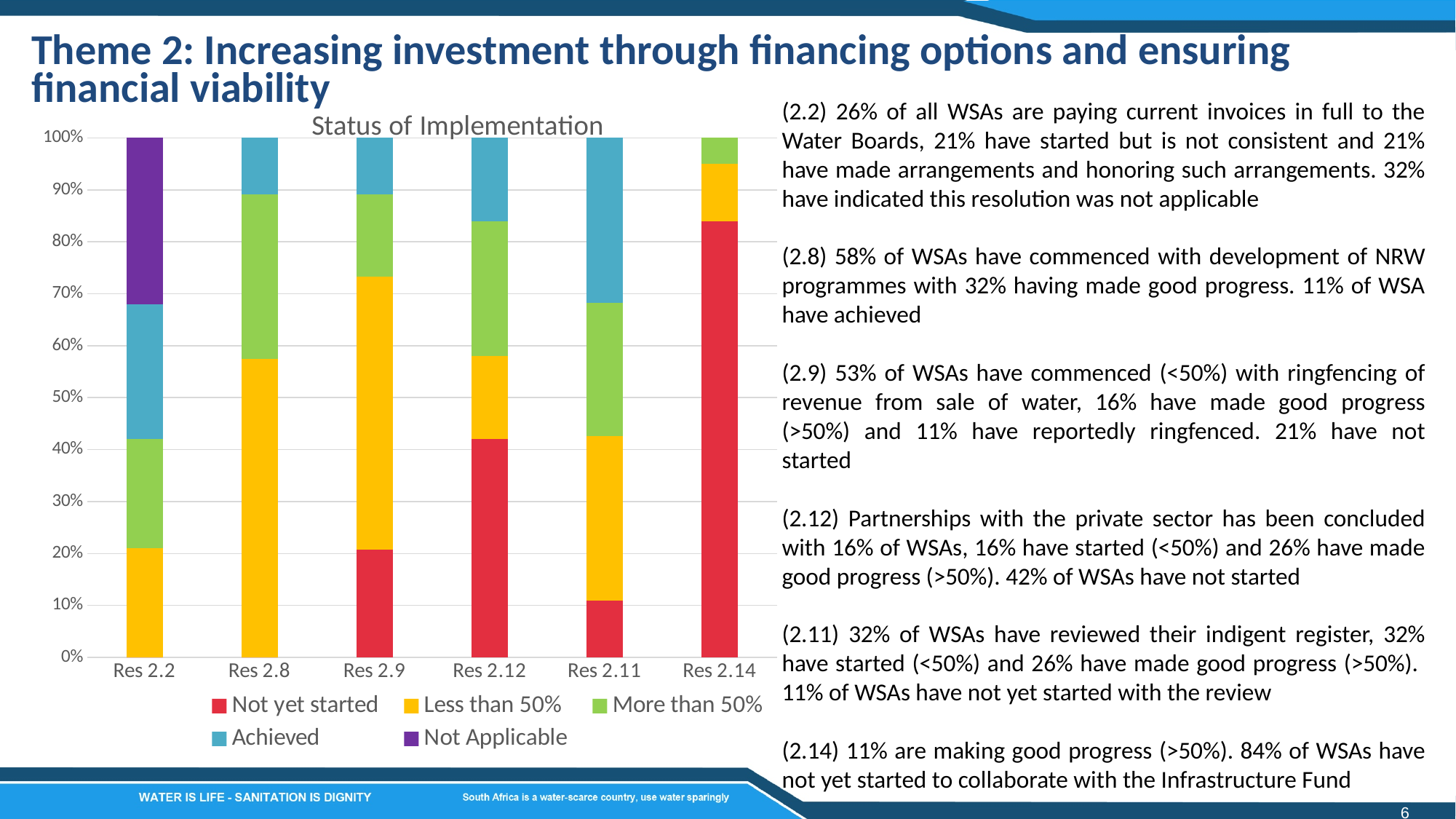
What is the title of the chart? Status of Implementation What type of chart is shown on the slide? Stacked bar chart Is the 'Not yet started' segment for Res 2.14 greater or less than 80%? greater What value does the top of each stacked bar reach on the y axis? 100% Which category is the only one with a 'Not Applicable' segment? Res 2.2 Which has the larger 'Not yet started' segment, Res 2.12 or Res 2.9? Res 2.12 Is the 'Not yet started' segment for Res 2.11 greater or less than 20%? less Is the 'Less than 50%' segment for Res 2.8 greater or less than 50%? greater How many categories (resolutions) are shown on the x axis of the chart? 6 Which colour represents the 'Not yet started' series in the chart? Red Which category has the largest 'Not yet started' segment? Res 2.14 How many series does the chart legend list? 5